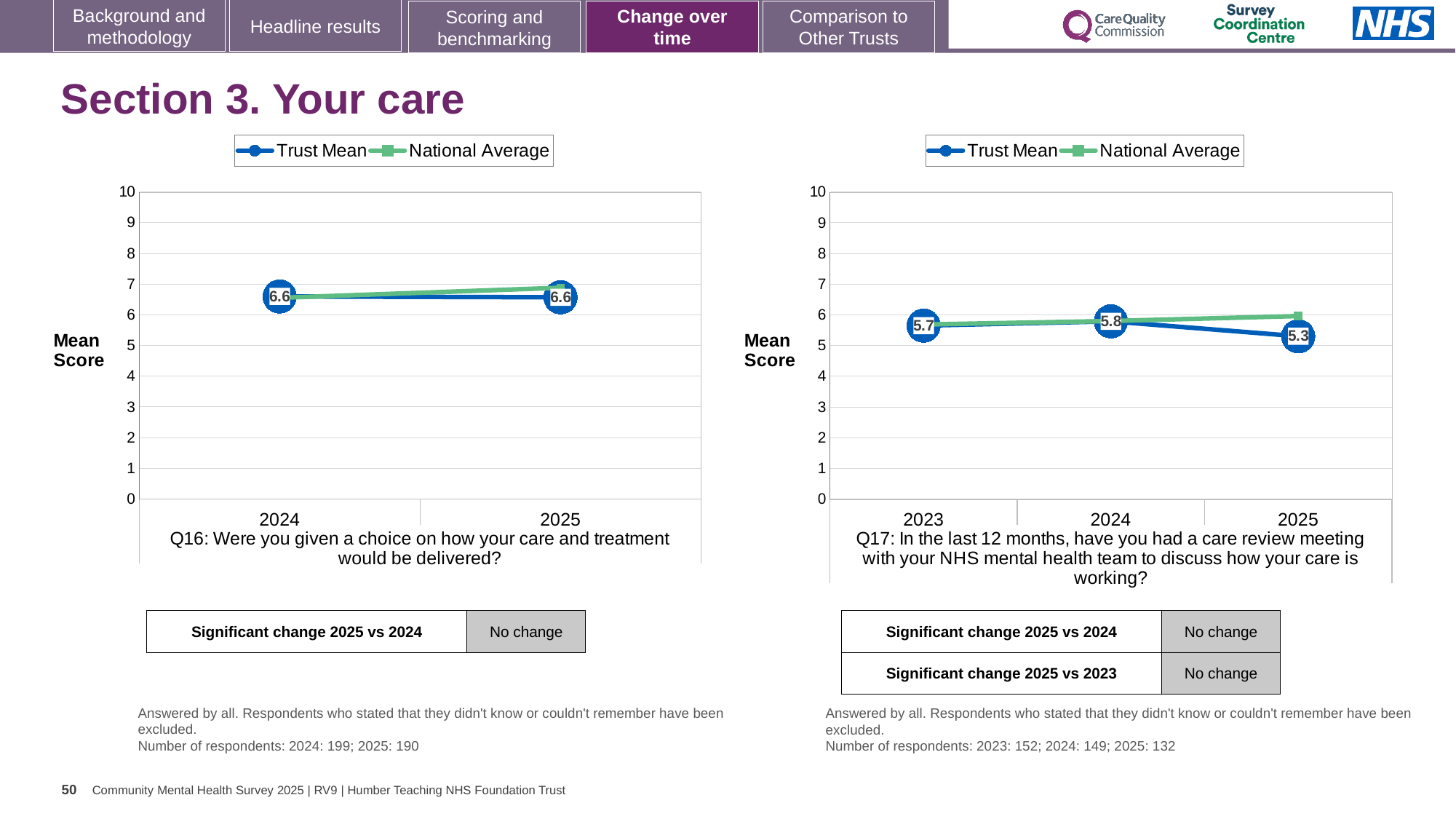
In the Q16 chart on the left, what is the Trust Mean for 2025? 6.6 In the Q17 chart on the right, is the Trust Mean for 2024 or 2025 larger? 2024 In the Q17 chart on the right, which year has the highest Trust Mean? 2024 In the Q17 chart on the right, what is the Trust Mean for 2025? 5.3 How many years are plotted on the x axis of the Q17 chart on the right? 3 In the Q17 chart on the right, which year has the lowest Trust Mean? 2025 What kind of chart is the Q16 chart on the left? Line chart In the Q17 chart on the right, what is the difference between the Trust Mean for 2024 and 2025? 0.5 In the Q17 chart on the right, what is the Trust Mean for 2023? 5.7 How many series does the legend of the Q16 chart on the left list? 2 In the Q17 chart on the right, is the National Average for 2025 greater or less than 5? greater In the Q16 chart on the left, what is the Trust Mean for 2024? 6.6